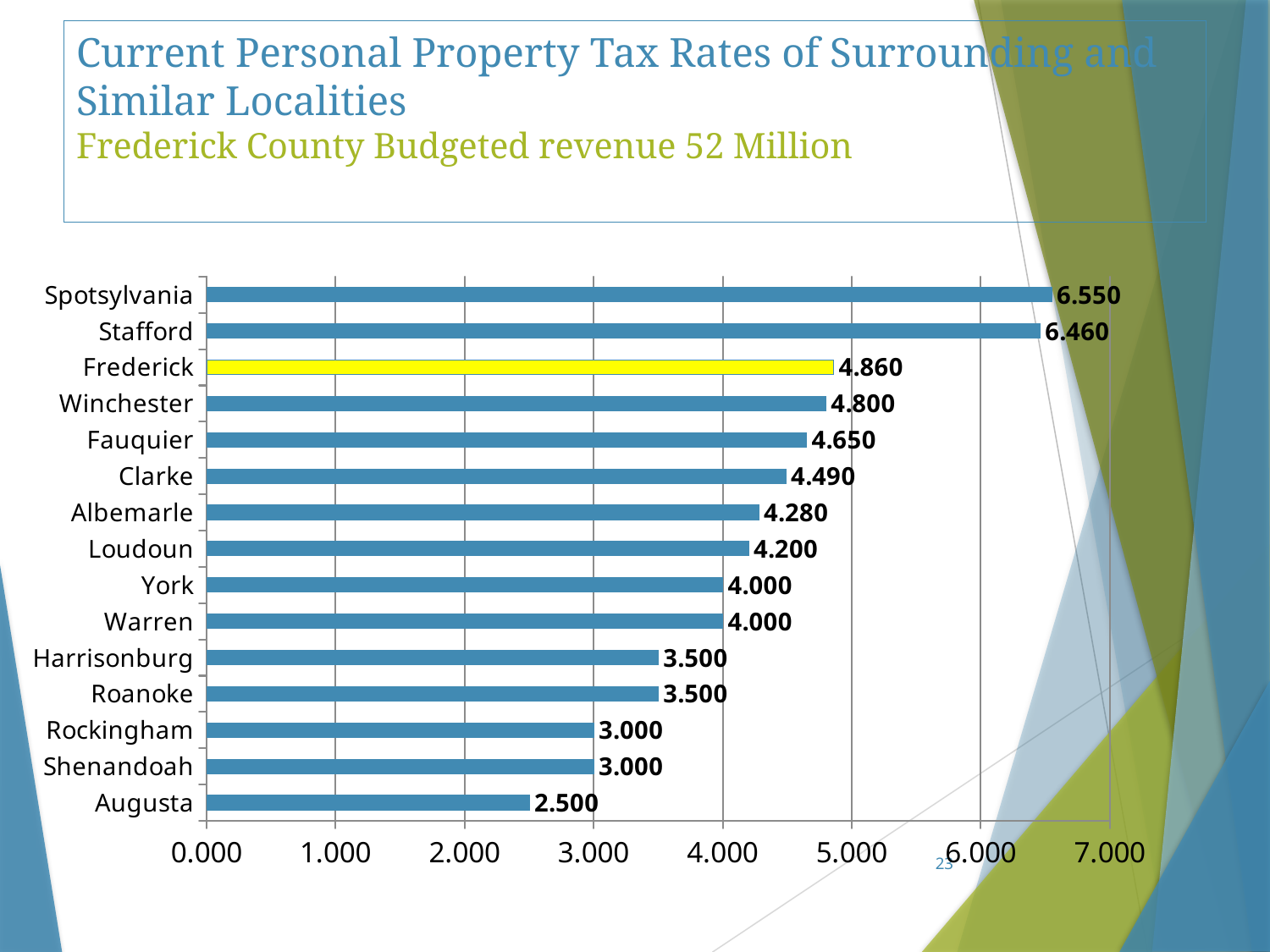
Which locality has the highest tax rate on the chart? Spotsylvania Is the value for Loudoun greater or less than 4.000? greater What is the personal property tax rate shown for Frederick? 4.860 Which locality's bar is highlighted in yellow? Frederick What is the difference between the values for Spotsylvania and Stafford? 0.090 What kind of chart is shown on the slide? Bar chart How many localities are shown on the chart? 15 Which has a higher value, Fauquier or Clarke? Fauquier What is the value shown for Winchester? 4.800 What is the value shown for Augusta? 2.500 Which locality has the lowest tax rate on the chart? Augusta What is the difference between the values for Frederick and Winchester? 0.060